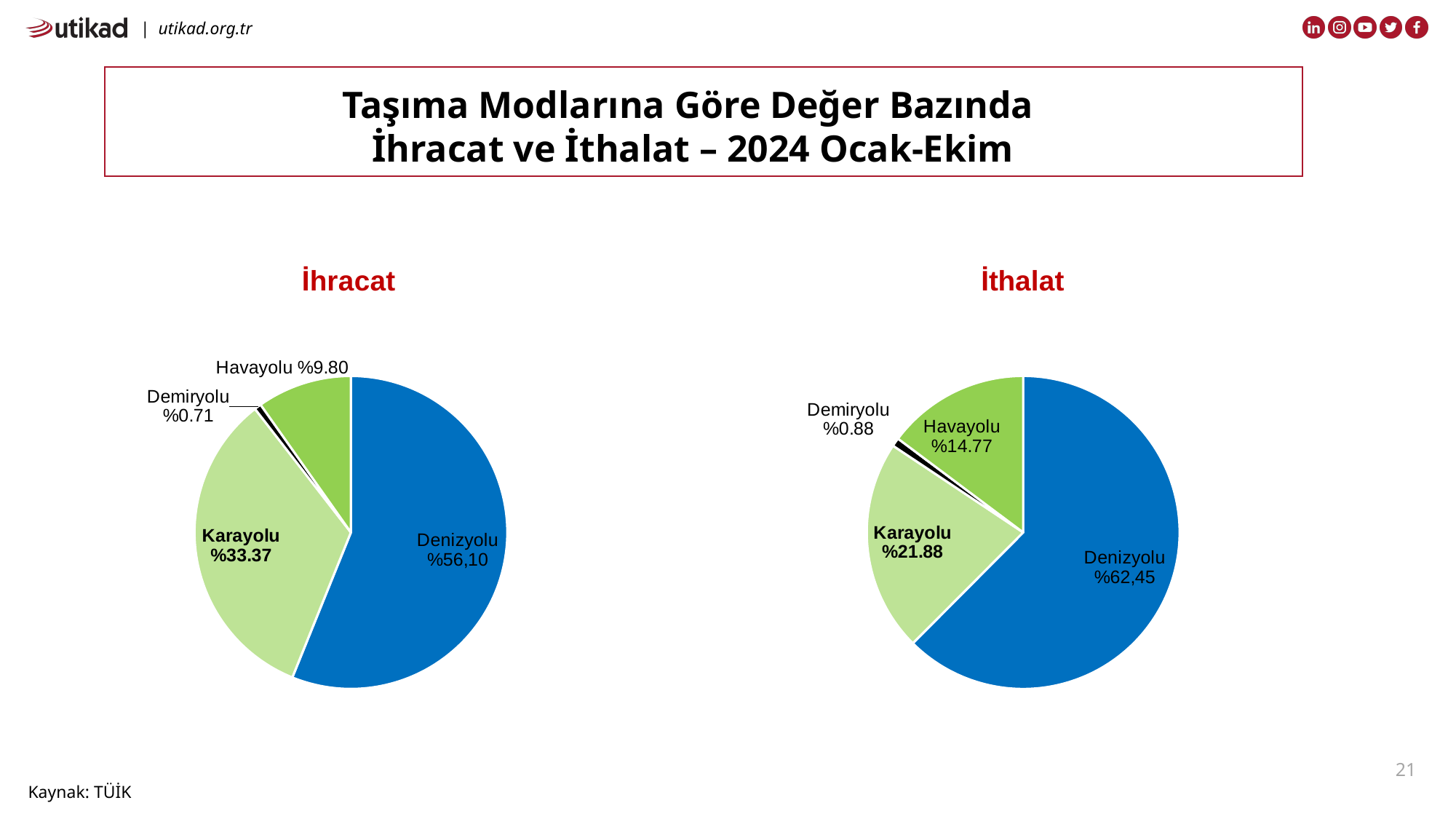
In the İhracat chart, what is the share for Karayolu? %33.37 In the İthalat chart, what is the share for Demiryolu? %0.88 In the İthalat chart, what is the difference between the Karayolu share and the Havayolu share? %7.11 In the İhracat chart, how many slices does the pie have? 4 In the İthalat chart, what is the share for Havayolu? %14.77 Is the Denizyolu share larger in the İhracat chart or in the İthalat chart? İthalat In the İhracat chart, what is the share for Denizyolu? %56,10 In the İhracat chart, which transport mode has the largest share? Denizyolu What type of charts are shown on the slide? Pie charts In the İthalat chart, which transport mode has the smallest share? Demiryolu What is the source cited at the bottom of the slide? TÜİK In the İhracat chart, what is the difference between the Karayolu share and the Havayolu share? %23.57